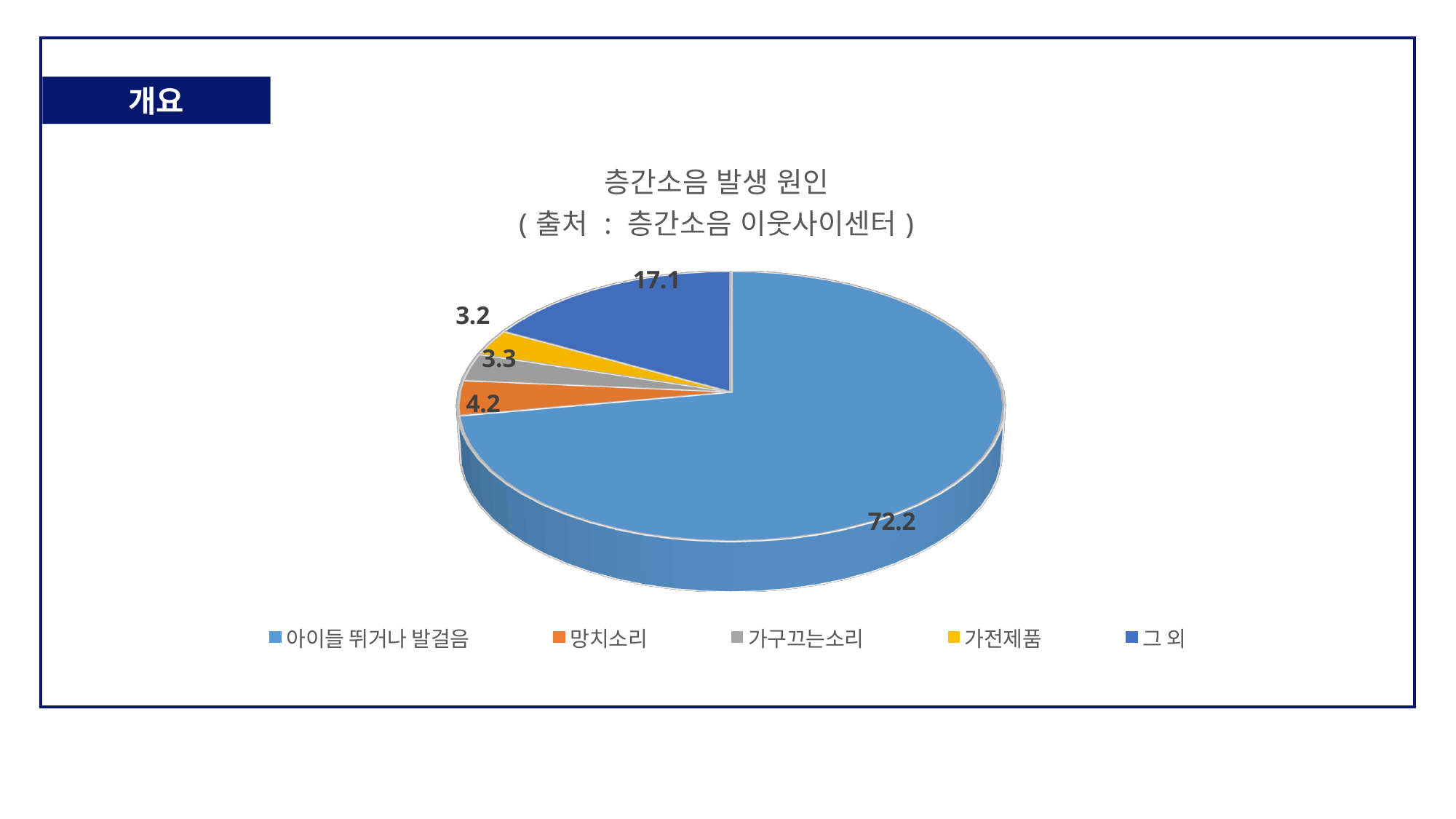
What is the value for 가구끄는소리? 3.3 What is the value for 망치소리? 4.2 Which category has the smallest slice? 가전제품 Which is larger, the value for 망치소리 or the value for 그 외? 그 외 What is the value for 그 외? 17.1 What is the title of the chart? 층간소음 발생 원인 ( 출처 : 층간소음 이웃사이센터 ) What is the value for 아이들 뛰거나 발걸음? 72.2 What is the value for 가전제품? 3.2 Which category has the largest slice? 아이들 뛰거나 발걸음 What type of chart is shown on the slide? pie chart How many categories does the pie chart have? 5 What is the difference between the values for 아이들 뛰거나 발걸음 and 그 외? 55.1